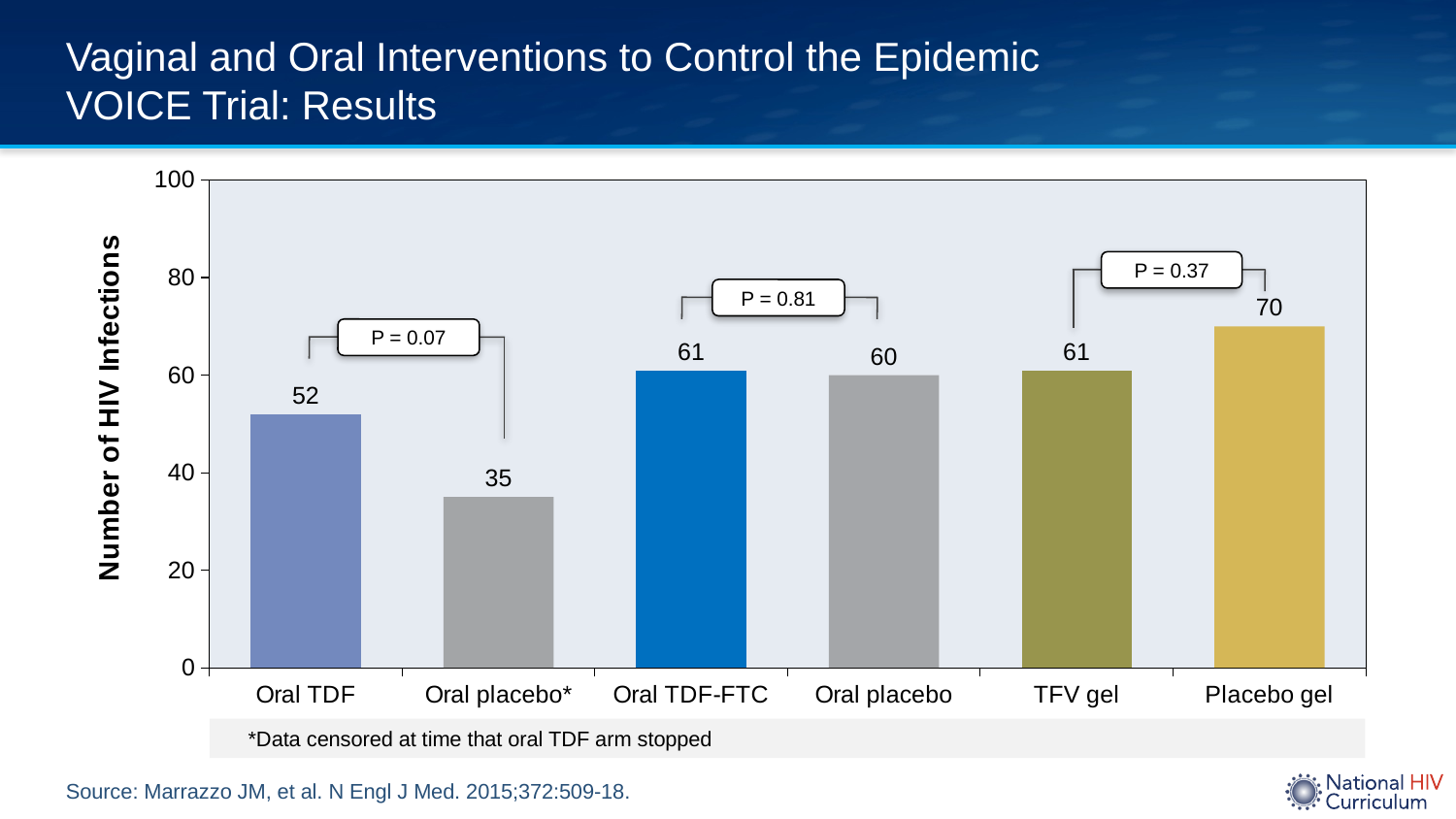
What is the difference in HIV infections between Placebo gel and TFV gel? 9 Which arm has the highest number of HIV infections? Placebo gel What P value is shown for the comparison between TFV gel and Placebo gel? P = 0.37 What kind of chart is shown on the slide? Bar chart Which arm has the lowest number of HIV infections? Oral placebo* Is the value for Oral placebo* greater or less than 40? less What is the number of HIV infections for Oral TDF? 52 How many trial arms are shown on the x axis? 6 What is the number of HIV infections for Oral placebo* (the arm censored when the oral TDF arm stopped)? 35 Which has more HIV infections, Oral TDF or Oral TDF-FTC? Oral TDF-FTC What is the difference in HIV infections between Oral TDF and Oral placebo*? 17 What is the number of HIV infections for Placebo gel? 70